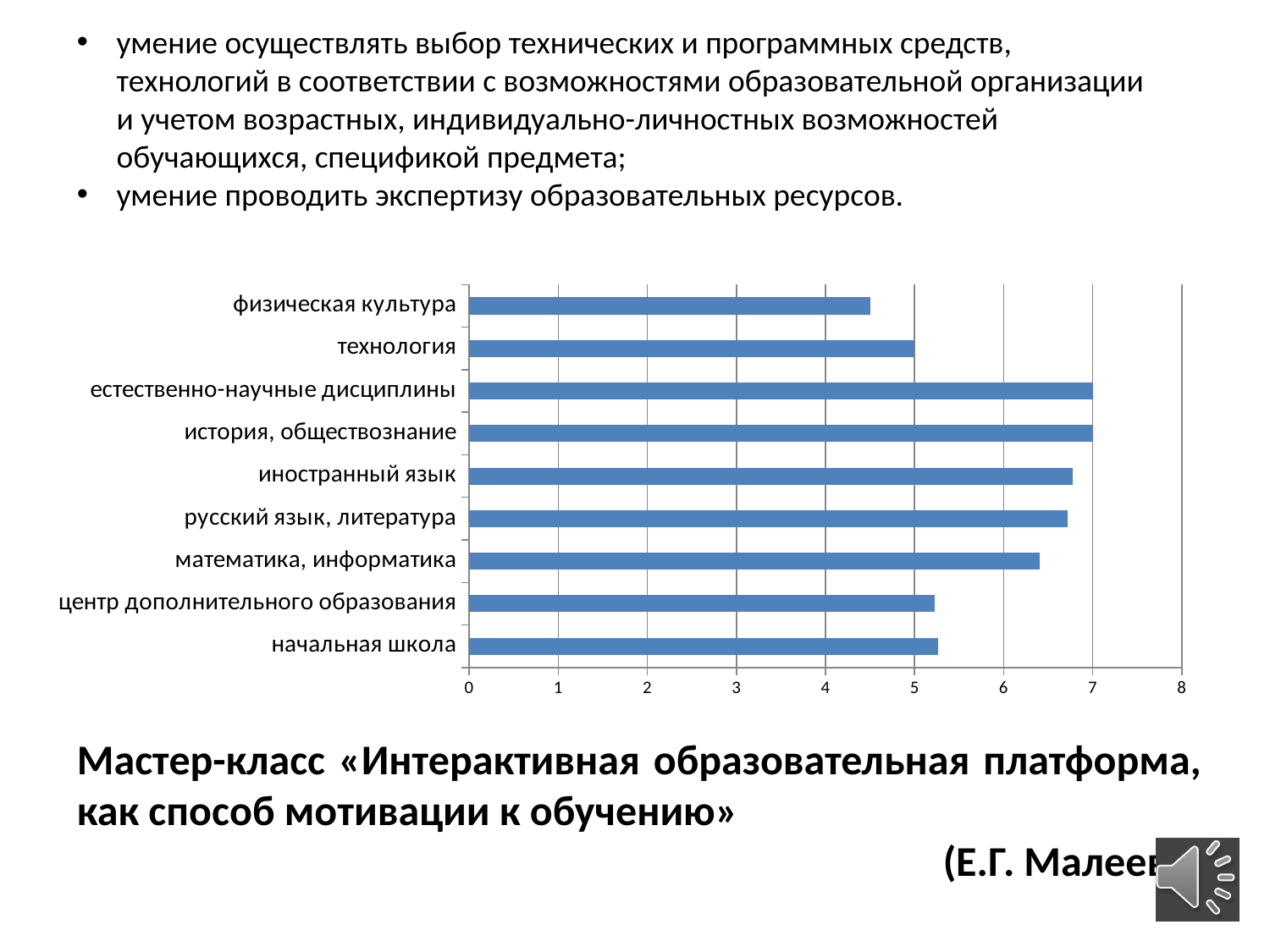
Is the value for физическая культура greater or less than 5? less How many categories are shown in the bar chart? 9 What kind of chart is shown on the slide? bar chart Which category has the lowest value in the bar chart? физическая культура Is the value for центр дополнительного образования greater or less than 6? less Which has a larger value: русский язык, литература or центр дополнительного образования? русский язык, литература Is the value for математика, информатика greater or less than 6? greater What is the value for технология in the bar chart? 5 What is the maximum value shown on the horizontal axis of the chart? 8 Which has a larger value: математика, информатика or технология? математика, информатика